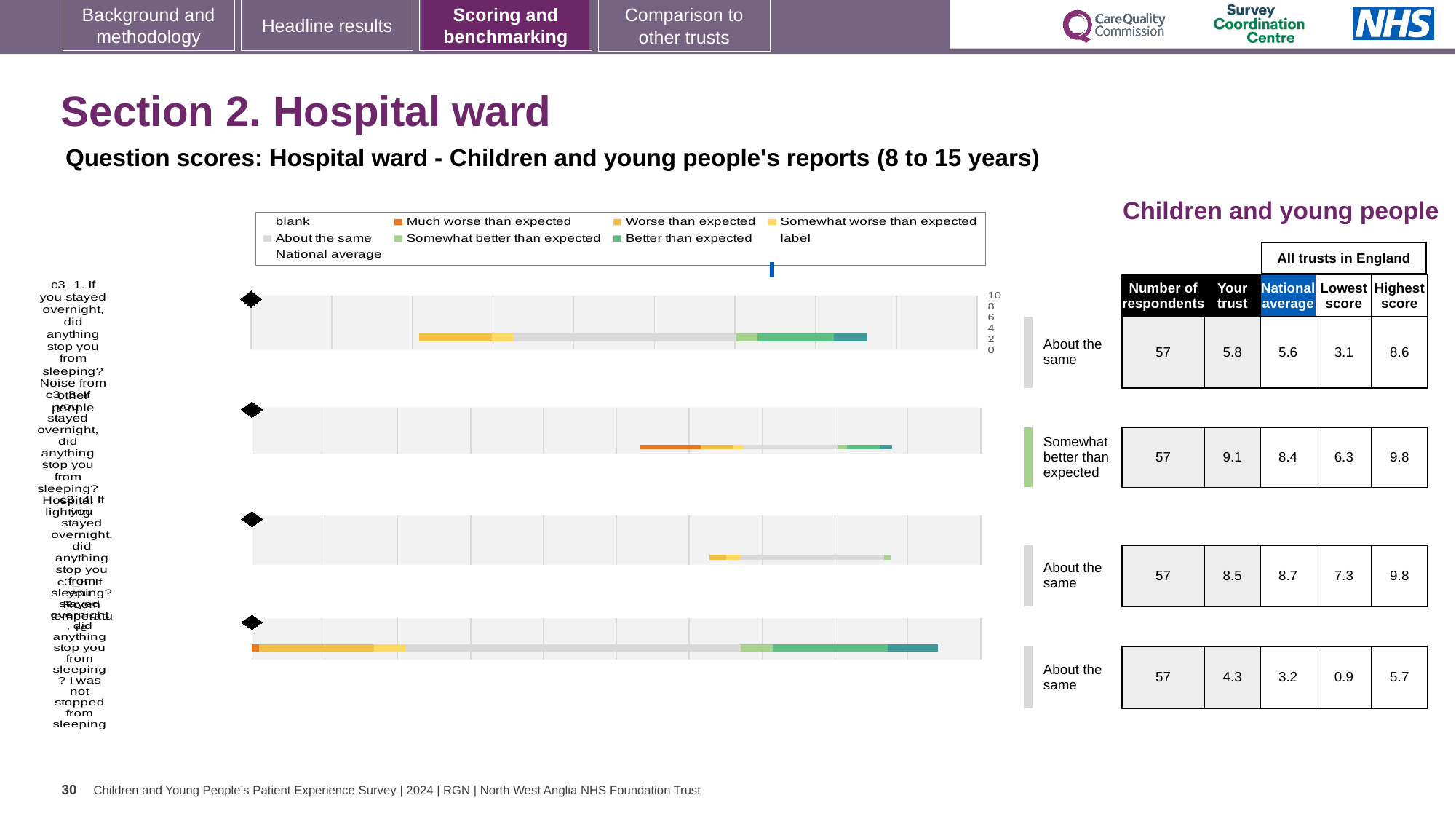
Which of the four charts is rated 'Somewhat better than expected' in the label beside it? the second chart (c3_3, hospital lighting) For the top chart (c3_1, noise from other people), what is the national average shown in the table beside it? 5.6 For the second chart (c3_3, hospital lighting), what is the difference between the 'Your trust' score (9.1) and the national average (8.4)? 0.7 How many entries does the legend above the charts list? 9 For the second chart (c3_3, hospital lighting), what is the 'Your trust' score shown in the table beside it? 9.1 For the top chart (c3_1, noise from other people), what is the 'Your trust' score shown in the table beside it? 5.8 What colour does the legend use for 'Better than expected'? teal For the second chart (c3_3, hospital lighting), which is larger: the 'Your trust' score or the national average? Your trust How many separate benchmark bar charts are shown on the slide? 4 What kind of chart is used for the four benchmark rows on this slide? bar chart What colour does the legend use for 'Much worse than expected'? orange For the bottom chart (c3_6, I was not stopped from sleeping), what is the lowest score across all trusts in England shown in the table? 0.9